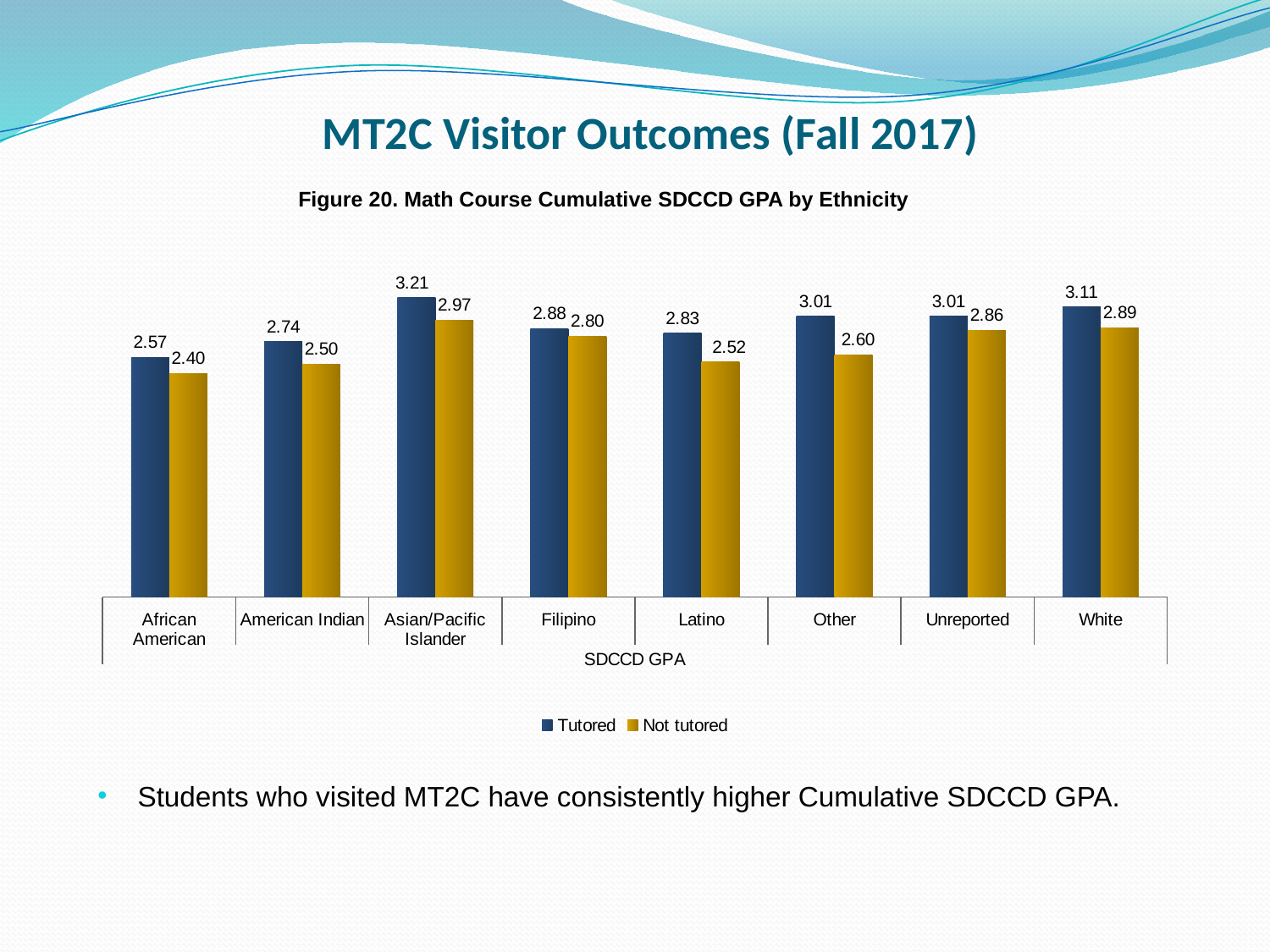
What is the difference between the Tutored and Not tutored GPA for Filipino students? 0.08 What kind of chart is shown on the slide? Bar chart What is the title of the chart? Figure 20. Math Course Cumulative SDCCD GPA by Ethnicity How many series does the legend list? 2 What is the Tutored GPA for White students? 3.11 What is the Tutored GPA for Asian/Pacific Islander students? 3.21 Which ethnicity has the lowest Not tutored GPA? African American How many ethnicity categories are shown on the x axis? 8 What is the Not tutored GPA for Latino students? 2.52 What is the difference between the Tutored and Not tutored GPA for Other? 0.41 Which ethnicity has the highest Tutored GPA? Asian/Pacific Islander Which is larger, the Not tutored GPA for Unreported or the Not tutored GPA for Latino? Unreported